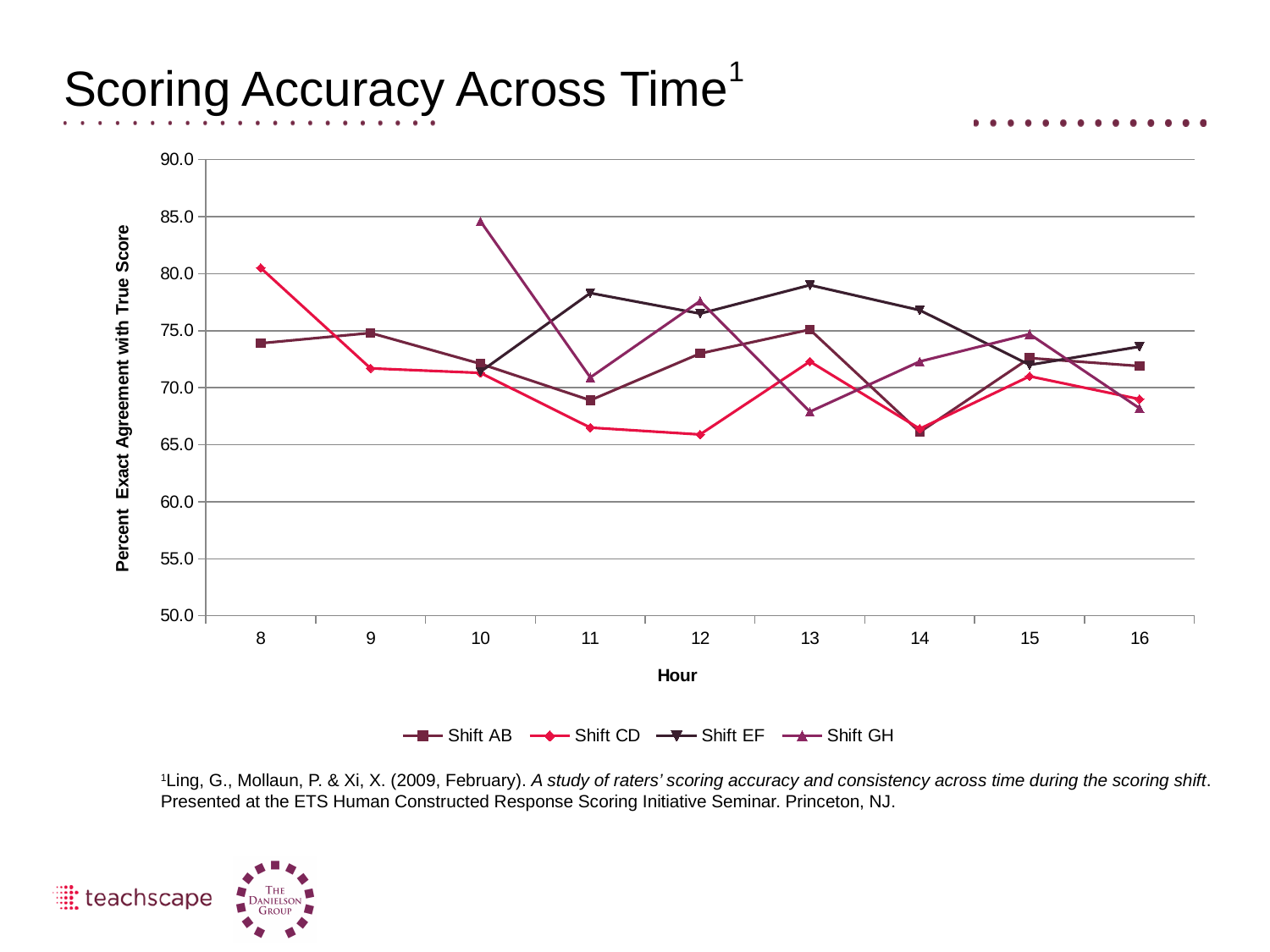
What is the title of the y axis? Percent Exact Agreement with True Score Is the value for Shift AB at hour 14 greater or less than 70.0? less Is the value for Shift GH at hour 10 greater or less than 80.0? greater Which shift has the highest value at hour 13? Shift EF Is the value for Shift CD at hour 8 greater or less than 75.0? greater How many series does the legend list? 4 What kind of chart is shown on the slide? Line chart At hour 11, which is larger: the value for Shift EF or the value for Shift AB? Shift EF Which shift has the lowest value at hour 12? Shift CD How many hours are marked along the x axis? 9 Which shift has the highest value at hour 10? Shift GH